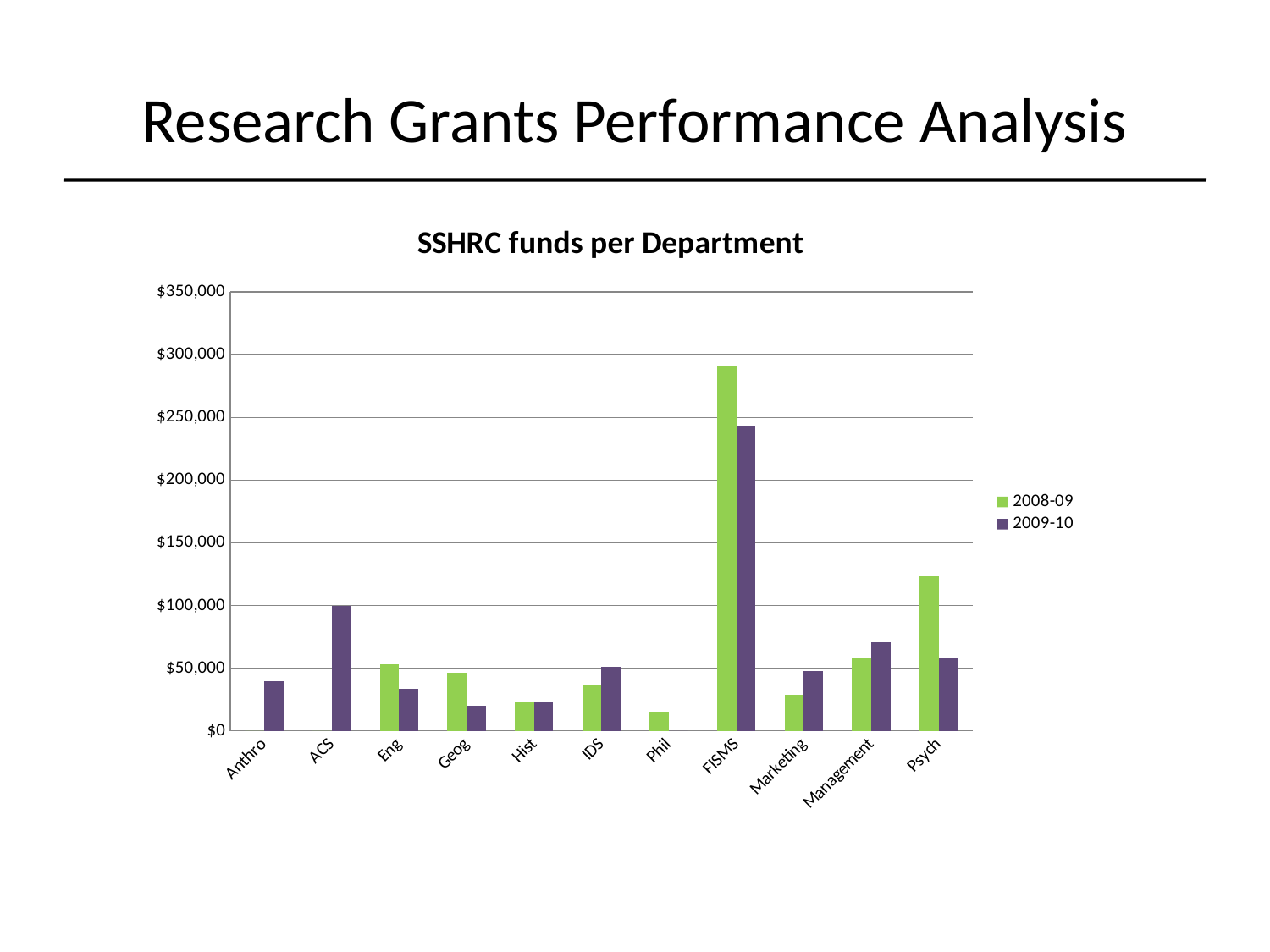
Is the 2008-09 value for Psych greater or less than $100,000? greater Is the 2008-09 value for FISMS greater or less than $250,000? greater For IDS, which series has the larger value, 2008-09 or 2009-10? 2009-10 How many departments are shown on the x axis? 11 What is the title of the chart? SSHRC funds per Department Is the 2009-10 value for Management greater or less than $50,000? greater Which department has the highest 2009-10 value? FISMS For Psych, which series has the larger value, 2008-09 or 2009-10? 2008-09 Which department has the highest 2008-09 value? FISMS What type of chart is shown on the slide? Bar chart How many series does the legend list? 2